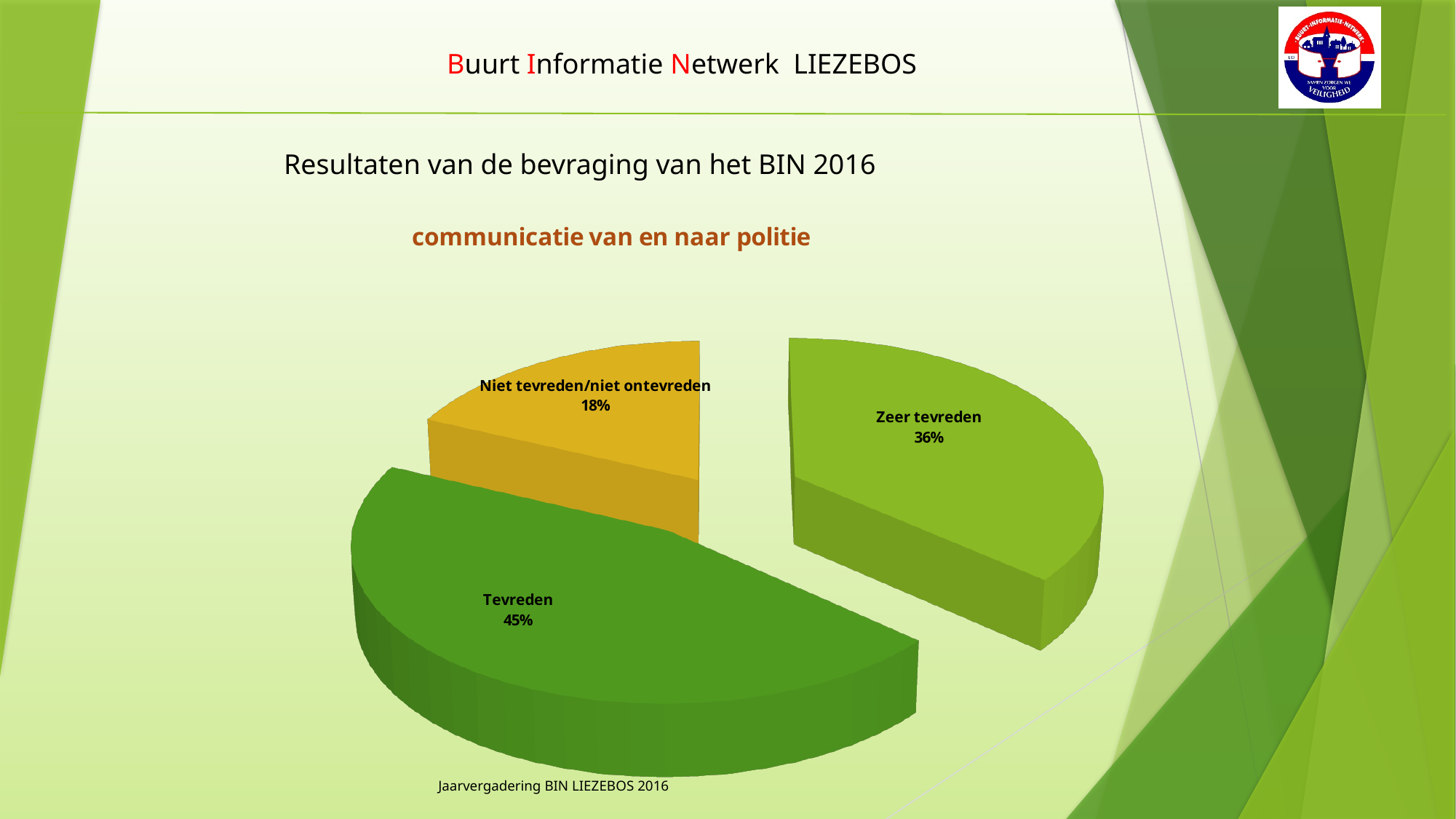
What is the title of the chart? communicatie van en naar politie What percentage of respondents answered 'Zeer tevreden'? 36% Which category has the largest share of the pie? Tevreden What percentage of respondents answered 'Niet tevreden/niet ontevreden'? 18% What is the difference in percentage points between 'Zeer tevreden' and 'Niet tevreden/niet ontevreden'? 18 Which category has the smallest share of the pie? Niet tevreden/niet ontevreden What kind of chart is shown on the slide? pie chart What is the difference in percentage points between 'Tevreden' and 'Zeer tevreden'? 9 What percentage of respondents answered 'Tevreden'? 45% How many slices does the pie chart have? 3 Which is larger, the share for 'Zeer tevreden' or the share for 'Niet tevreden/niet ontevreden'? Zeer tevreden What colour is the 'Niet tevreden/niet ontevreden' slice? yellow